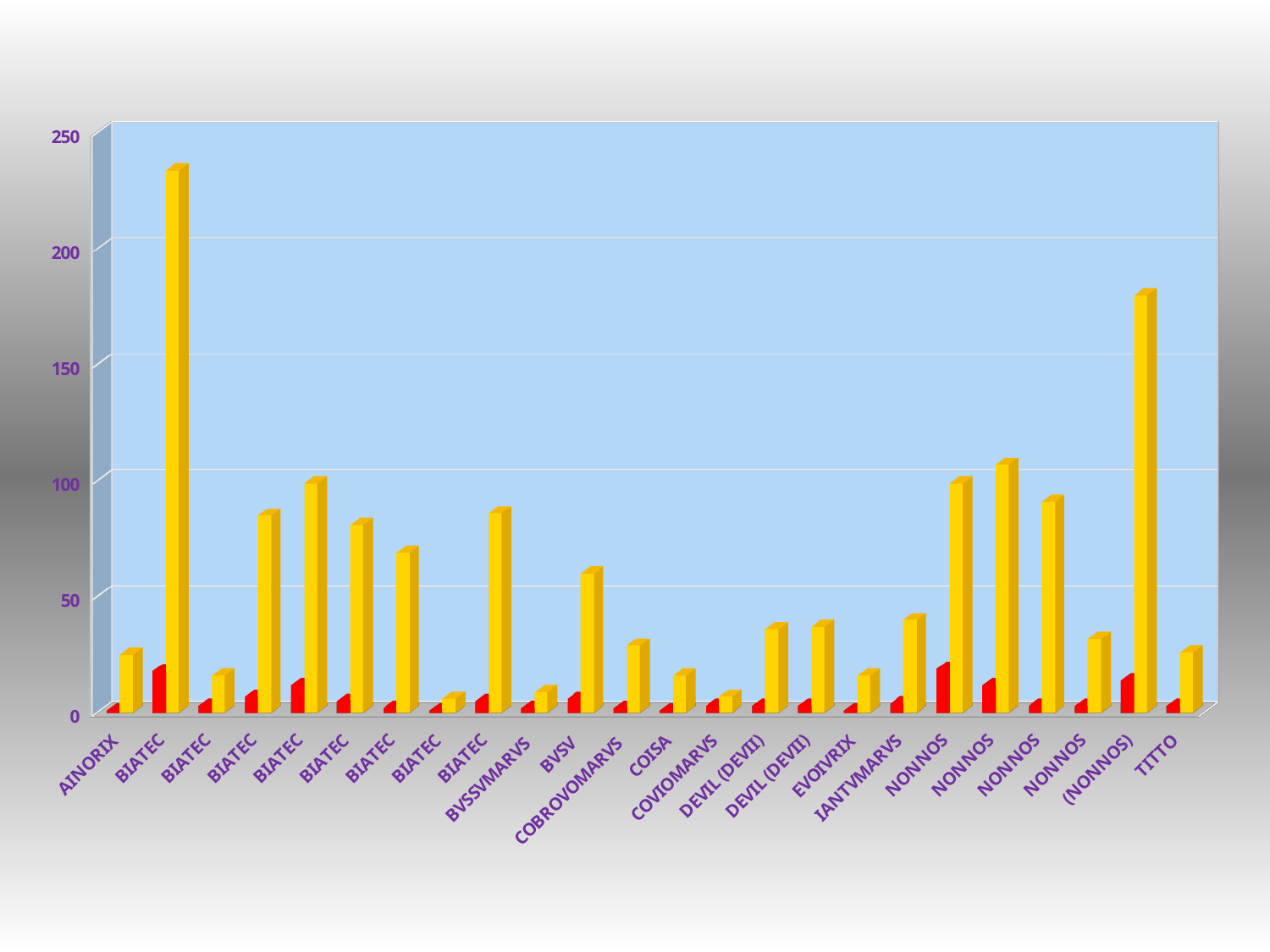
Is the yellow bar for AINORIX greater or less than 50? less Is the yellow bar for BVSV greater or less than 50? greater Which category has the tallest yellow bar? BIATEC What is the highest value shown on the vertical axis? 250 How many categories are shown along the x axis? 24 Is the yellow bar for IANTVMARVS greater or less than 50? less What kind of chart is shown on the slide? bar chart Which has the taller yellow bar, (NONNOS) or TITTO? (NONNOS) What two colours are used for the bars in the chart? yellow and red Which has the taller yellow bar, BVSV or COISA? BVSV